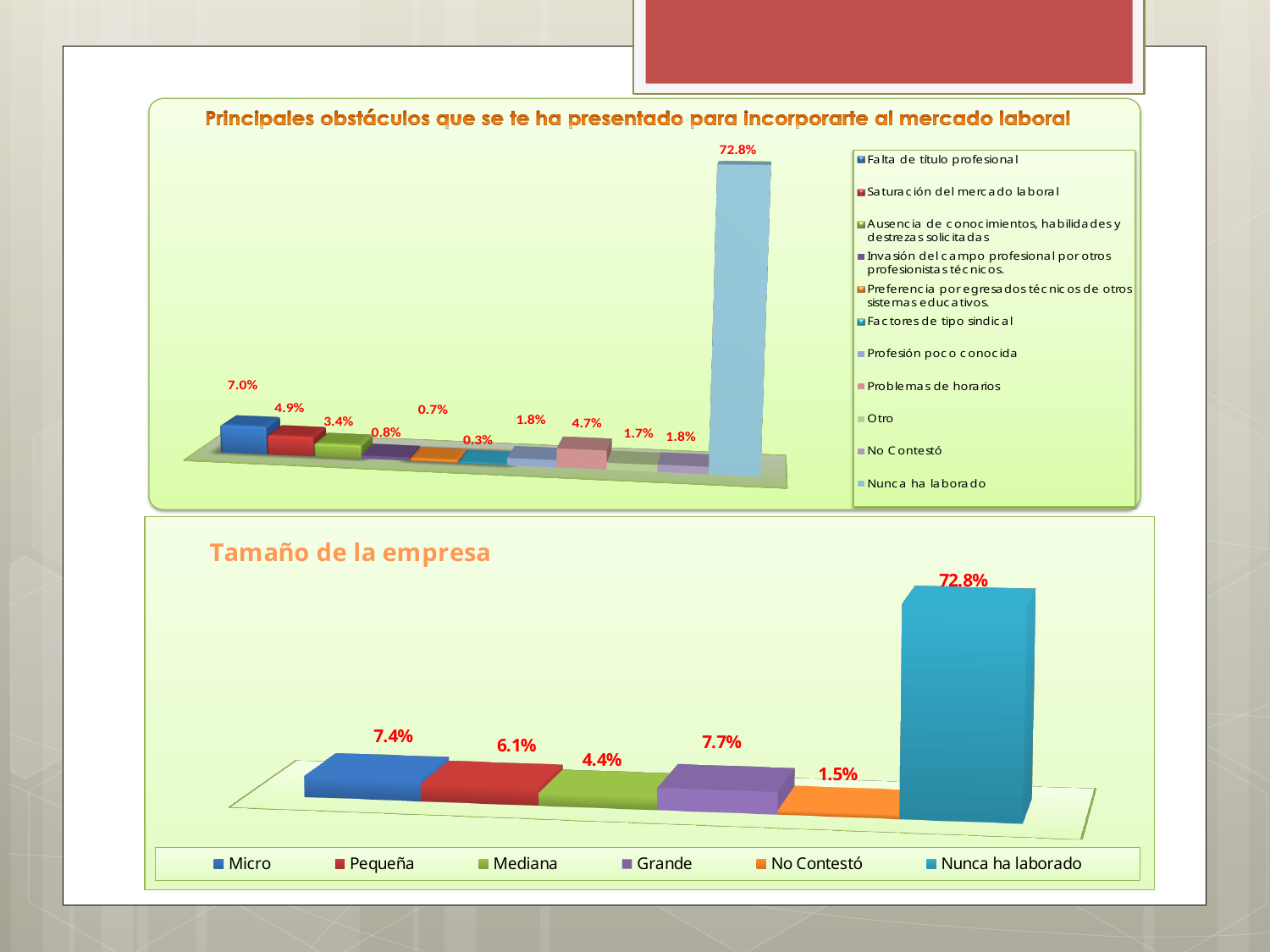
In the 'Tamaño de la empresa' chart, which is larger, the value for Micro or the value for Pequeña? Micro In the 'Principales obstáculos' chart, what is the value for Nunca ha laborado? 72.8% In the 'Principales obstáculos' chart, what is the value for Falta de título profesional? 7.0% In the 'Principales obstáculos' chart, how many entries does the legend list? 11 In the 'Tamaño de la empresa' chart, which category has the lowest value? No Contestó In the 'Tamaño de la empresa' chart, which category has the highest value? Nunca ha laborado In the 'Principales obstáculos' chart, which category has the lowest value? Factores de tipo sindical In the 'Tamaño de la empresa' chart, what is the difference between the values for Pequeña and Mediana? 1.7% In the 'Tamaño de la empresa' chart, how many categories does the legend list? 6 In the 'Tamaño de la empresa' chart, what is the value for Micro? 7.4% What kind of chart is the 'Tamaño de la empresa' chart? Bar chart In the 'Tamaño de la empresa' chart, what is the value for Grande? 7.7%